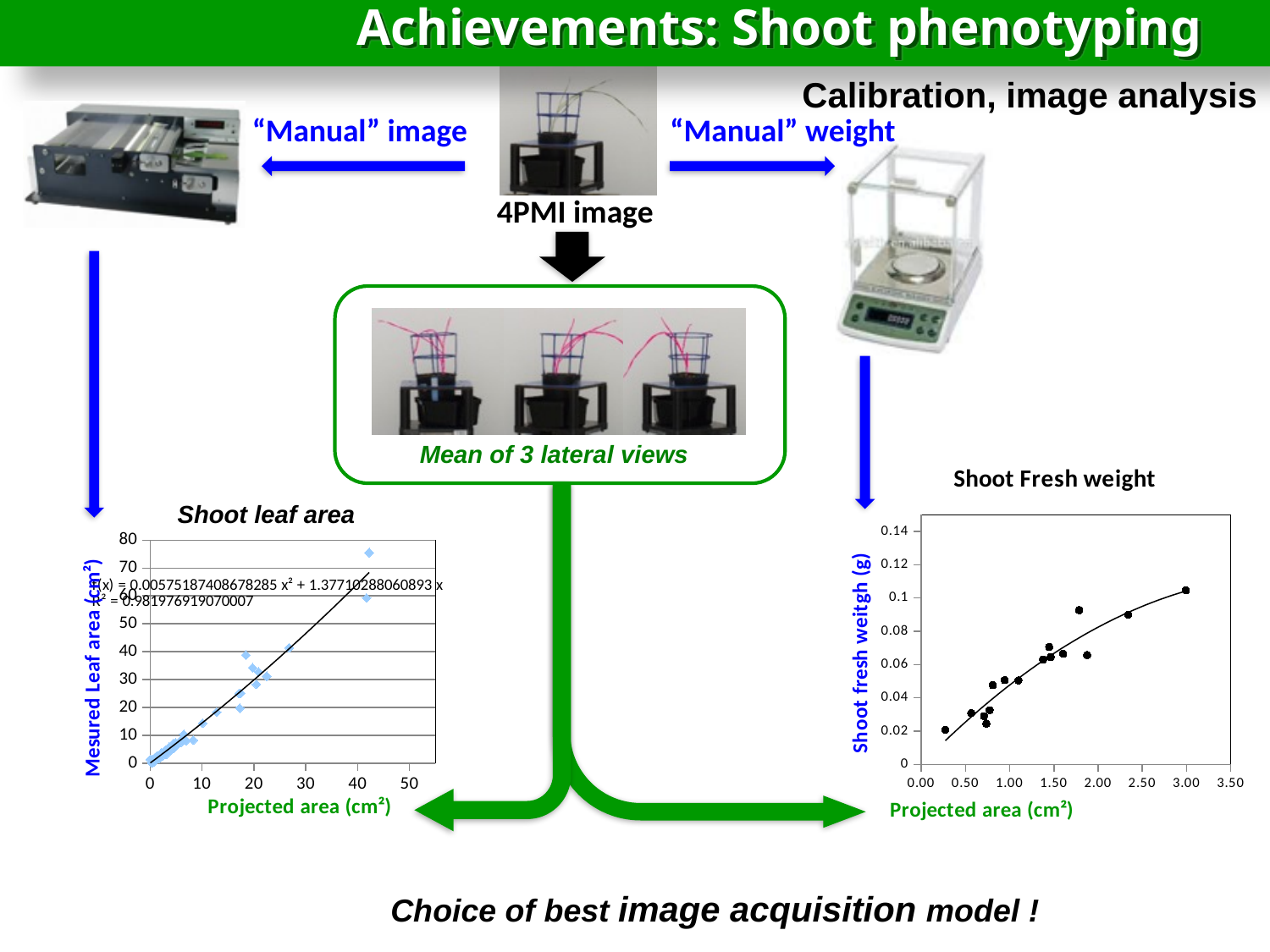
In the 'Shoot leaf area' chart, is the highest measured leaf area value greater or less than 70? greater In the 'Shoot Fresh weight' chart, do the shoot fresh weight values rise or fall as projected area increases? rise What kind of chart is the 'Shoot Fresh weight' chart? scatter chart What is the maximum value shown on the y axis of the 'Shoot leaf area' chart? 80 In the 'Shoot Fresh weight' chart, is the highest shoot fresh weight value greater or less than 0.12? less What kind of chart is the 'Shoot leaf area' chart? scatter chart In the 'Shoot Fresh weight' chart, is the lowest shoot fresh weight value greater or less than 0.04? less What is the x-axis title of the 'Shoot Fresh weight' chart? Projected area (cm²) In the 'Shoot leaf area' chart, do the measured leaf area values rise or fall as projected area increases? rise